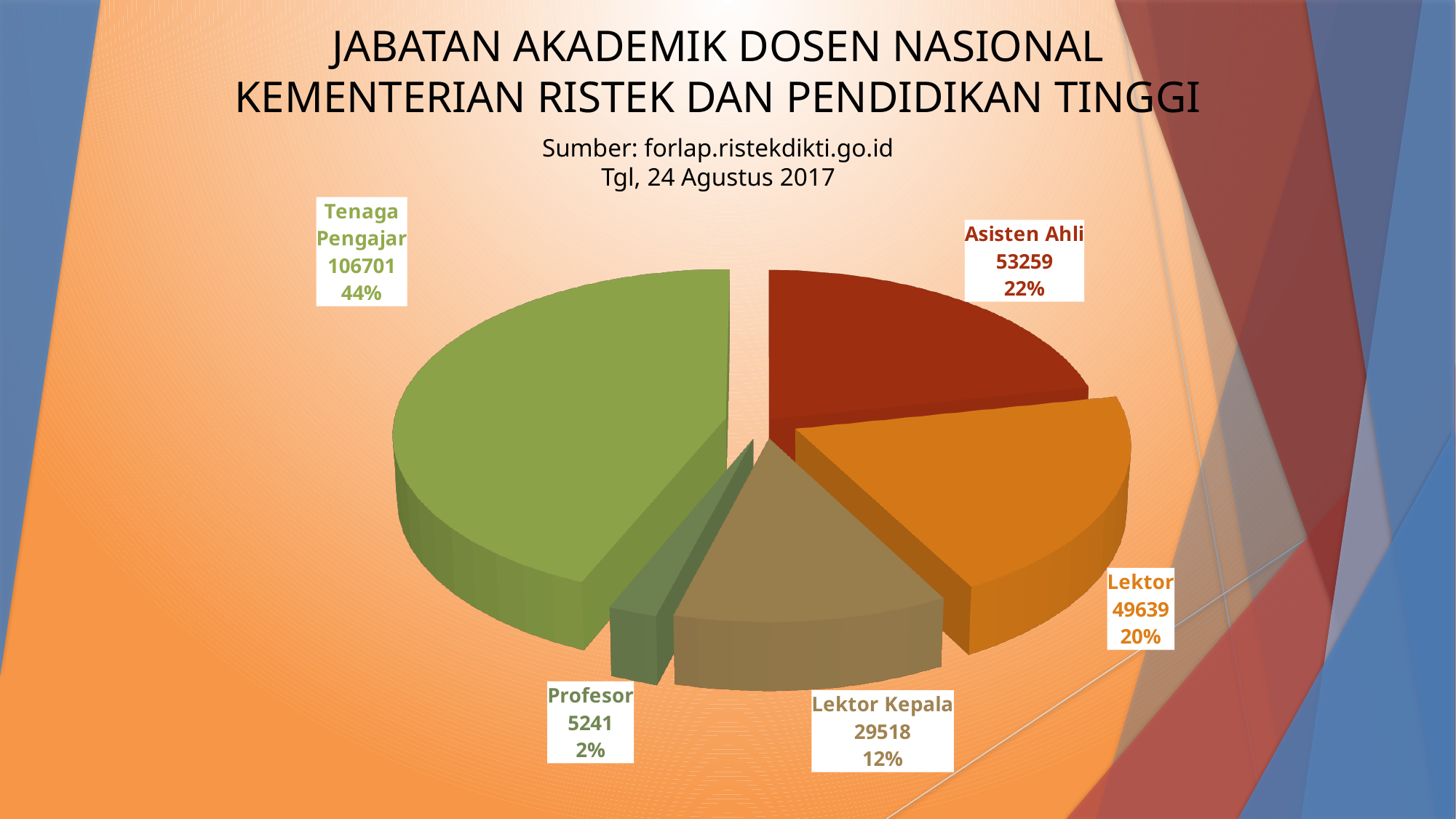
Which category has the largest slice? Tenaga Pengajar What is the value for Lektor Kepala? 29518 How many slices does the pie chart have? 5 What share of the pie does Asisten Ahli represent? 22% What is the difference between the values for Asisten Ahli and Lektor? 3620 What share of the pie does Lektor represent? 20% What is the value for Tenaga Pengajar? 106701 What kind of chart is shown on the slide? Pie chart Which category has the smallest slice? Profesor What source is cited below the chart title? forlap.ristekdikti.go.id What is the value for Profesor? 5241 Which is larger, the value for Lektor Kepala or the value for Profesor? Lektor Kepala